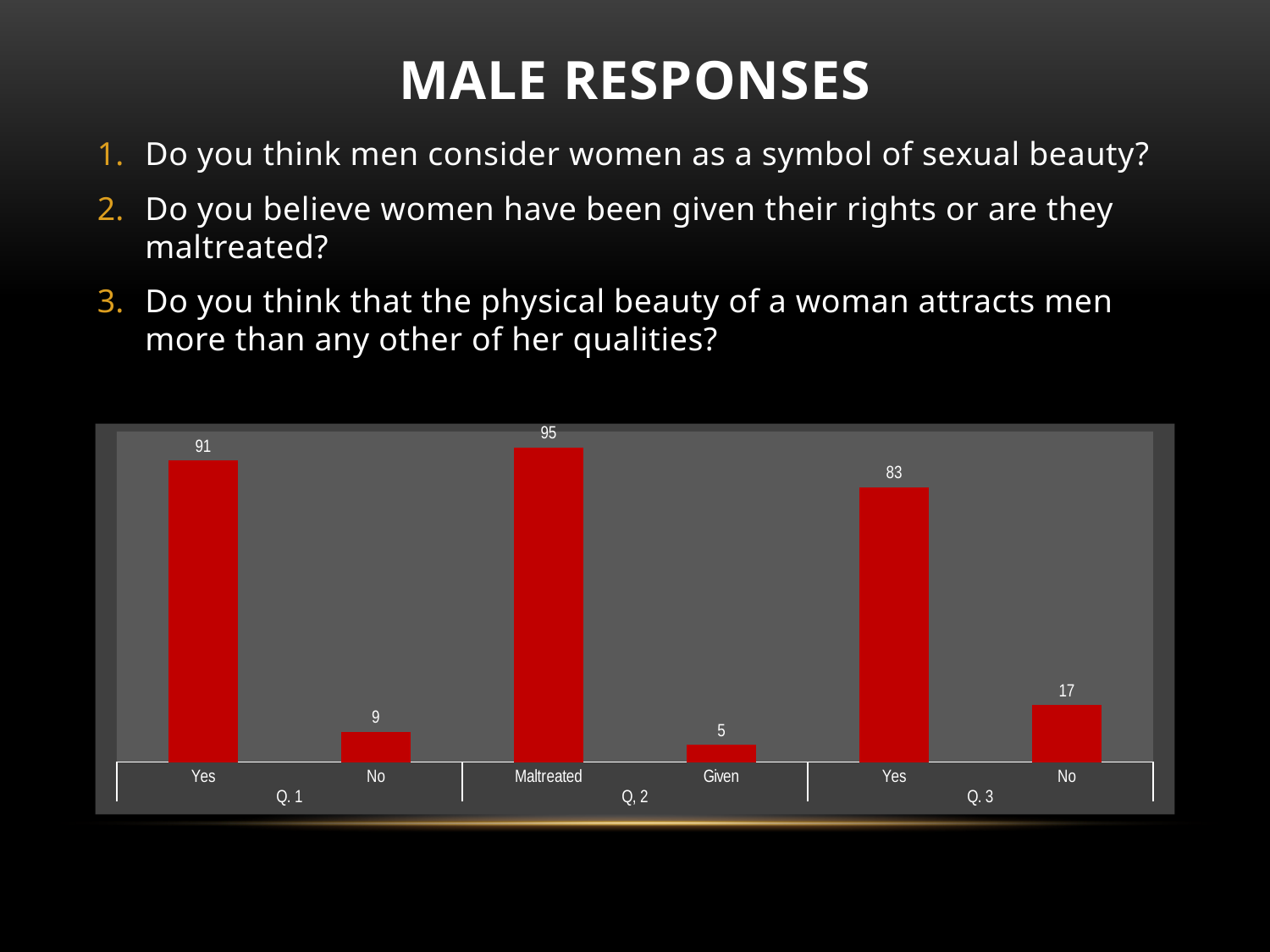
What is the value for "Yes" under Q. 3? 83 What is the value for "Maltreated" under Q, 2? 95 Which bar has the highest value in the chart? Maltreated (Q, 2) Which bar has the lowest value in the chart? Given (Q, 2) Which is larger: the "Yes" value under Q. 1 or the "Yes" value under Q. 3? Yes under Q. 1 What is the difference between the "Yes" and "No" values under Q. 3? 66 What is the value for "No" under Q. 1? 9 What is the value for "Yes" under Q. 1? 91 How many bars are plotted in the chart? 6 What is the value for "Given" under Q, 2? 5 What is the value for "No" under Q. 3? 17 What kind of chart is shown on the slide? Bar chart